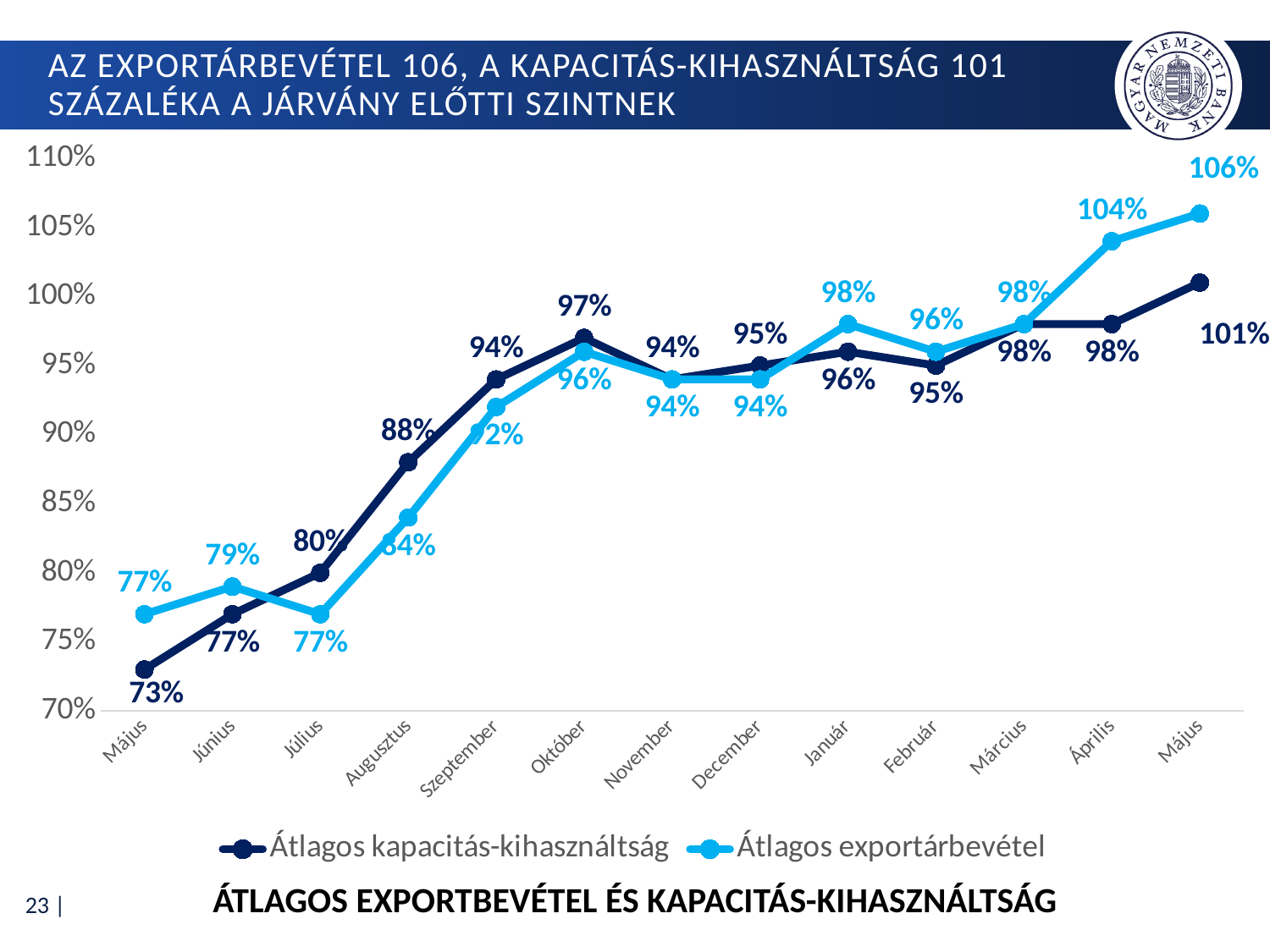
What is the value of Átlagos exportárbevétel in Április? 104% In Augusztus, which series has the larger value, Átlagos kapacitás-kihasználtság or Átlagos exportárbevétel? Átlagos kapacitás-kihasználtság How many data points does each line have along the x axis? 13 Which month has the highest value for Átlagos exportárbevétel? Május (the last point) What is the difference between Átlagos exportárbevétel and Átlagos kapacitás-kihasználtság at the last Május point? 5 percentage points Which month has the lowest value for Átlagos kapacitás-kihasználtság? Május (the first point) What is the value of Átlagos kapacitás-kihasználtság in Október? 97% What kind of chart is shown on the slide? line chart How many series does the legend list? 2 What is the title shown below the chart? ÁTLAGOS EXPORTBEVÉTEL ÉS KAPACITÁS-KIHASZNÁLTSÁG What is the value of Átlagos kapacitás-kihasználtság at the first Május point on the left? 73% Do the values of Átlagos exportárbevétel generally rise or fall from the first Május to the last Május? rise